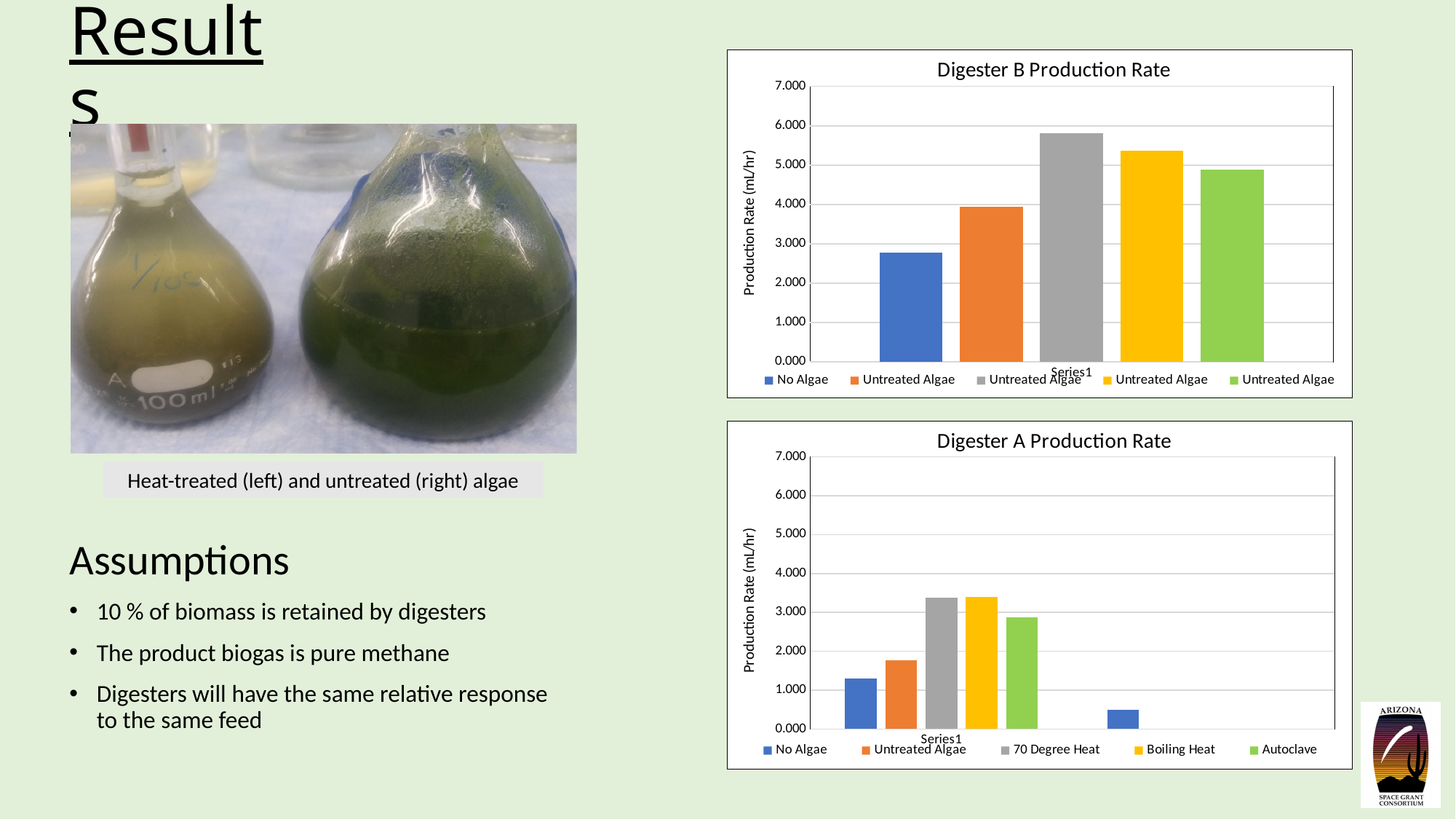
What is the y-axis label of the Digester B Production Rate chart? Production Rate (mL/hr) How many entries does the legend of the Digester B Production Rate chart list? 5 In the Digester A Production Rate chart, is the value for No Algae greater or less than 2.000? less In the Digester A Production Rate chart, is the value for Autoclave greater or less than 2.000? greater How many entries does the legend of the Digester A Production Rate chart list? 5 What is the title of the lower chart on the slide? Digester A Production Rate In the Digester A Production Rate chart, which is larger, the value for Untreated Algae or the value for Autoclave? Autoclave In the Digester B Production Rate chart, which series has the lowest bar? No Algae In the Digester B Production Rate chart, is the value for No Algae greater or less than 3.000? less What kind of chart is the Digester B Production Rate chart? bar chart In the Digester B Production Rate chart, which series has the highest bar? the gray bar (third legend entry, Untreated Algae)